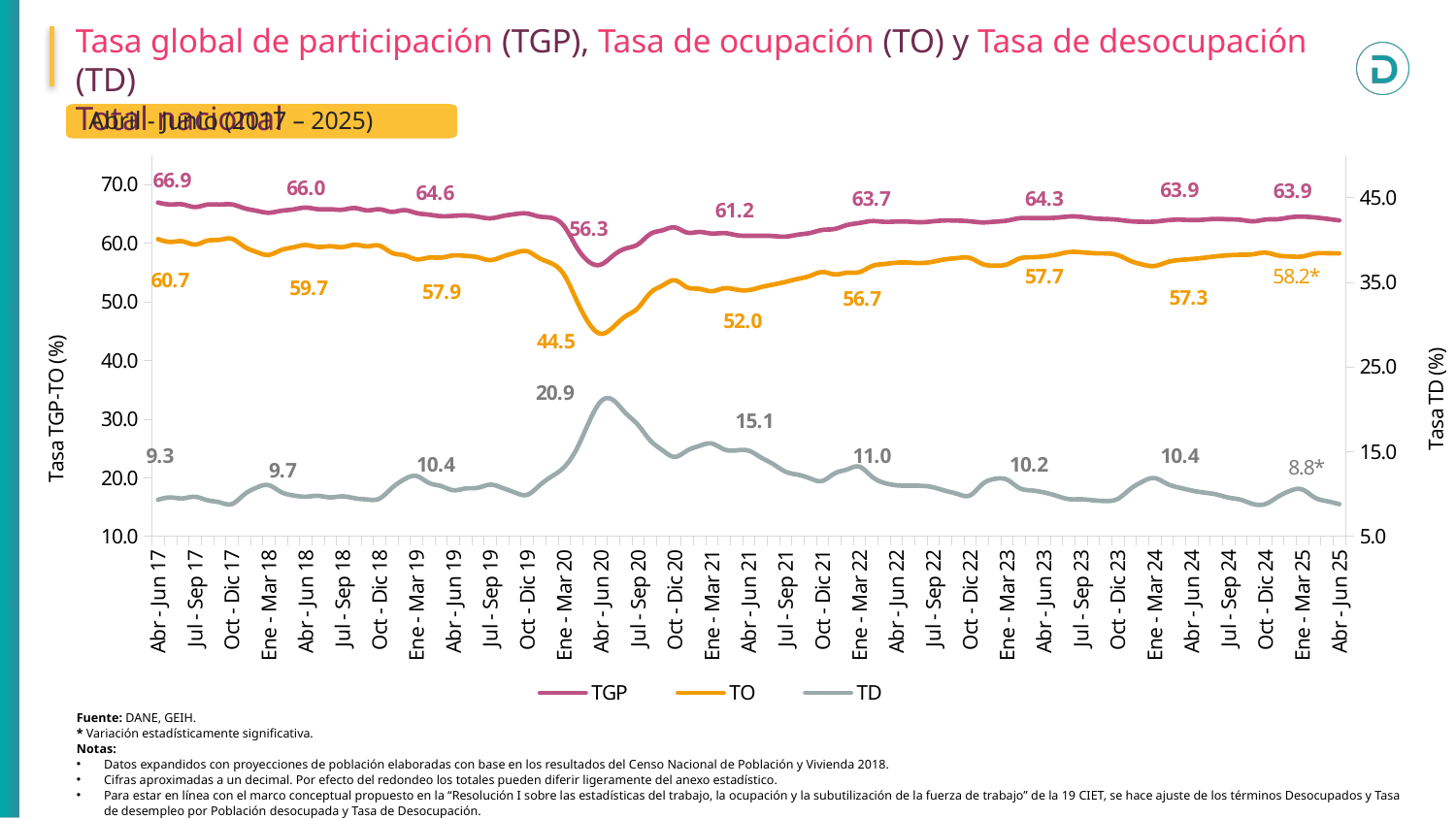
Which series is drawn in orange? TO What is the labelled TO value for Abr - Jun 25? 58.2* How many series does the legend list? 3 What is the labelled TO value for Abr - Jun 20? 44.5 What type of chart is shown on the slide? Line chart What is the difference between the labelled TGP values for Abr - Jun 17 and Abr - Jun 20? 10.6 Which is larger, the labelled TD value for Abr - Jun 21 or for Abr - Jun 22? Abr - Jun 21 What is the source cited below the chart? DANE, GEIH. Among the labelled TGP values, which period has the lowest value? Abr - Jun 20 What is the labelled TD value for Abr - Jun 20? 20.9 What is the labelled TGP value for Abr - Jun 17? 66.9 Among the labelled TD values, which period has the highest value? Abr - Jun 20